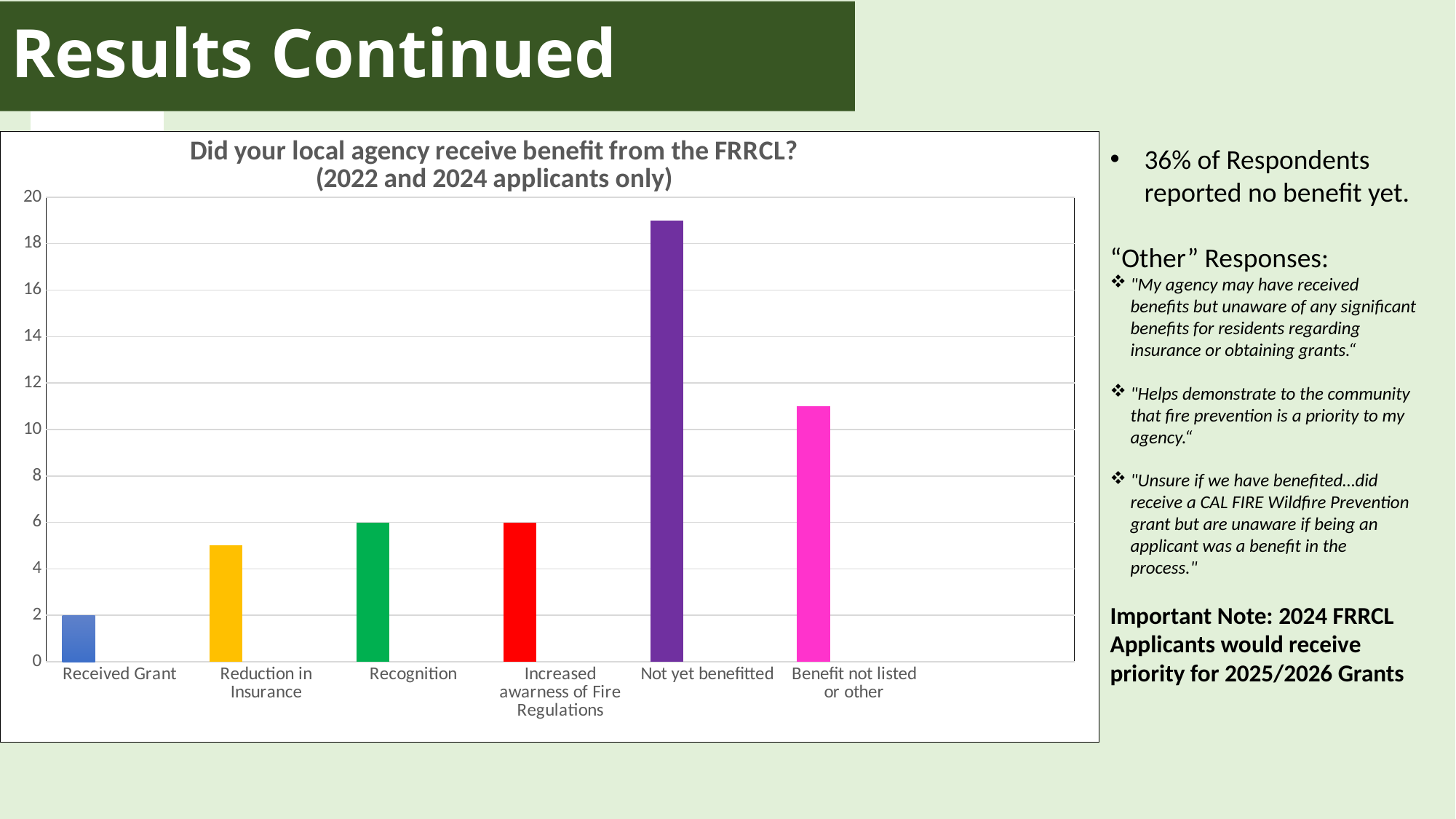
What is the difference between the values for Recognition and Received Grant? 4 What is the title of the chart? Did your local agency receive benefit from the FRRCL? (2022 and 2024 applicants only) What is the value for Increased awarness of Fire Regulations? 6 What is the value for Received Grant? 2 What is the value for Recognition? 6 Is the value for Not yet benefitted greater or less than 18? greater How many categories are shown on the x axis of the chart? 6 Is the value for Benefit not listed or other greater or less than 10? greater What type of chart is shown on the slide? bar chart Which category has the highest value? Not yet benefitted Which is larger, the value for Not yet benefitted or the value for Benefit not listed or other? Not yet benefitted Which category has the lowest value? Received Grant